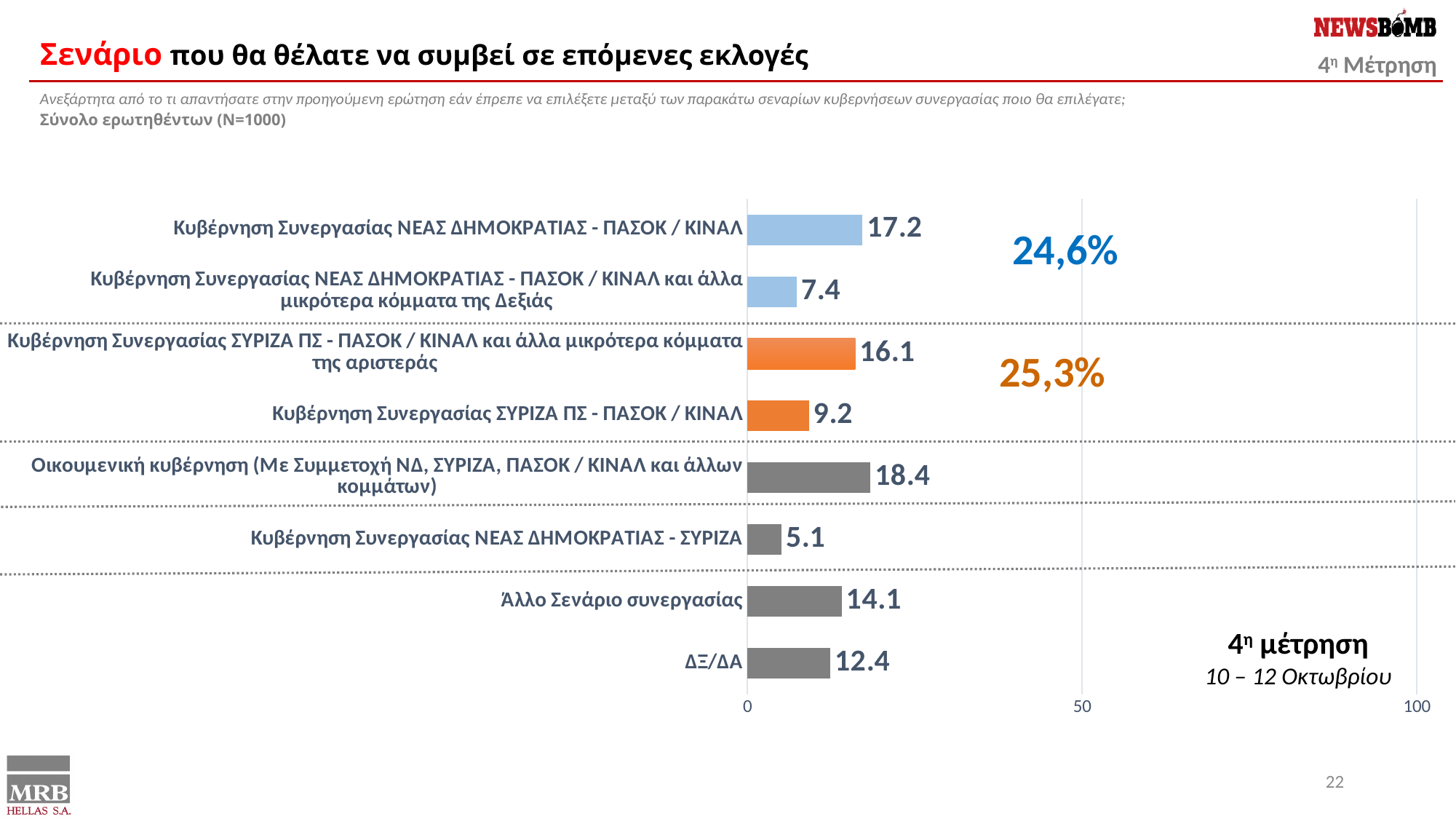
What combined percentage is shown next to the two orange bars (the ΣΥΡΙΖΑ ΠΣ scenarios)? 25,3% Which is larger: the value for Άλλο Σενάριο συνεργασίας or the value for ΔΞ/ΔΑ? Άλλο Σενάριο συνεργασίας How many categories are shown in the chart? 8 Is the value for Οικουμενική κυβέρνηση greater or less than 50? less What is the value for ΔΞ/ΔΑ? 12.4 What is the value for Οικουμενική κυβέρνηση (Με Συμμετοχή ΝΔ, ΣΥΡΙΖΑ, ΠΑΣΟΚ / ΚΙΝΑΛ και άλλων κομμάτων)? 18.4 Which category has the lowest value? Κυβέρνηση Συνεργασίας ΝΕΑΣ ΔΗΜΟΚΡΑΤΙΑΣ - ΣΥΡΙΖΑ What is the difference between the value for Κυβέρνηση Συνεργασίας ΝΕΑΣ ΔΗΜΟΚΡΑΤΙΑΣ - ΠΑΣΟΚ / ΚΙΝΑΛ and the value for Κυβέρνηση Συνεργασίας ΣΥΡΙΖΑ ΠΣ - ΠΑΣΟΚ / ΚΙΝΑΛ? 8.0 What is the value for Κυβέρνηση Συνεργασίας ΝΕΑΣ ΔΗΜΟΚΡΑΤΙΑΣ - ΠΑΣΟΚ / ΚΙΝΑΛ? 17.2 Which category has the highest value? Οικουμενική κυβέρνηση (Με Συμμετοχή ΝΔ, ΣΥΡΙΖΑ, ΠΑΣΟΚ / ΚΙΝΑΛ και άλλων κομμάτων) What is the value for Κυβέρνηση Συνεργασίας ΝΕΑΣ ΔΗΜΟΚΡΑΤΙΑΣ - ΣΥΡΙΖΑ? 5.1 What kind of chart is shown on the slide? bar chart